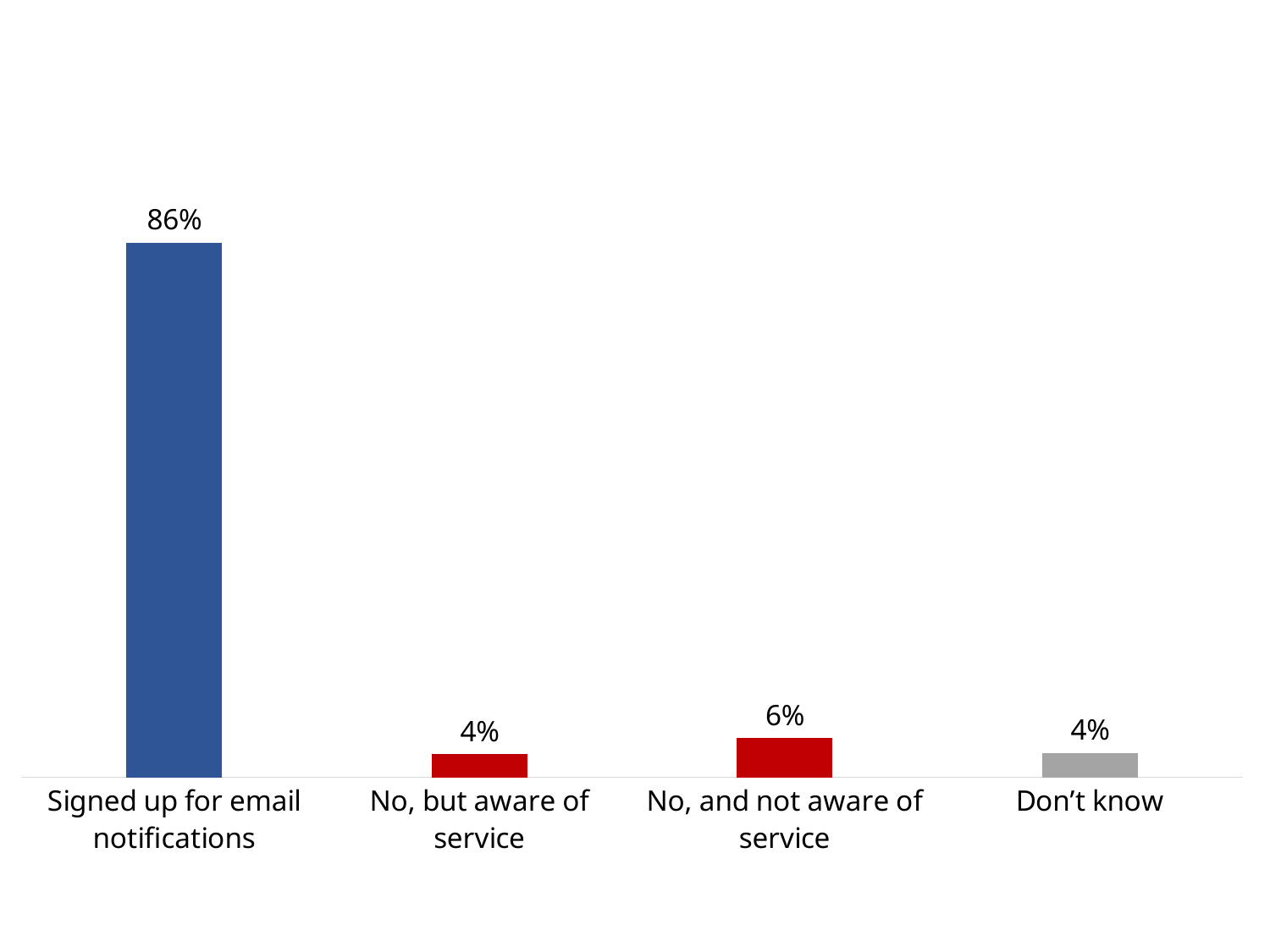
What is the value for "No, but aware of service"? 4% What percentage of respondents signed up for email notifications? 86% What colour is the bar for "Don't know"? Grey What kind of chart is shown on the slide? Bar chart What is the difference between "Signed up for email notifications" and "No, and not aware of service"? 80 percentage points What is the difference between "No, and not aware of service" and "No, but aware of service"? 2 percentage points How many categories are shown in the chart? 4 Which is larger: "No, and not aware of service" or "Don't know"? No, and not aware of service What colour is the bar for "Signed up for email notifications"? Blue What is the value for "Don't know"? 4% What is the value for "No, and not aware of service"? 6% Which category has the highest value? Signed up for email notifications